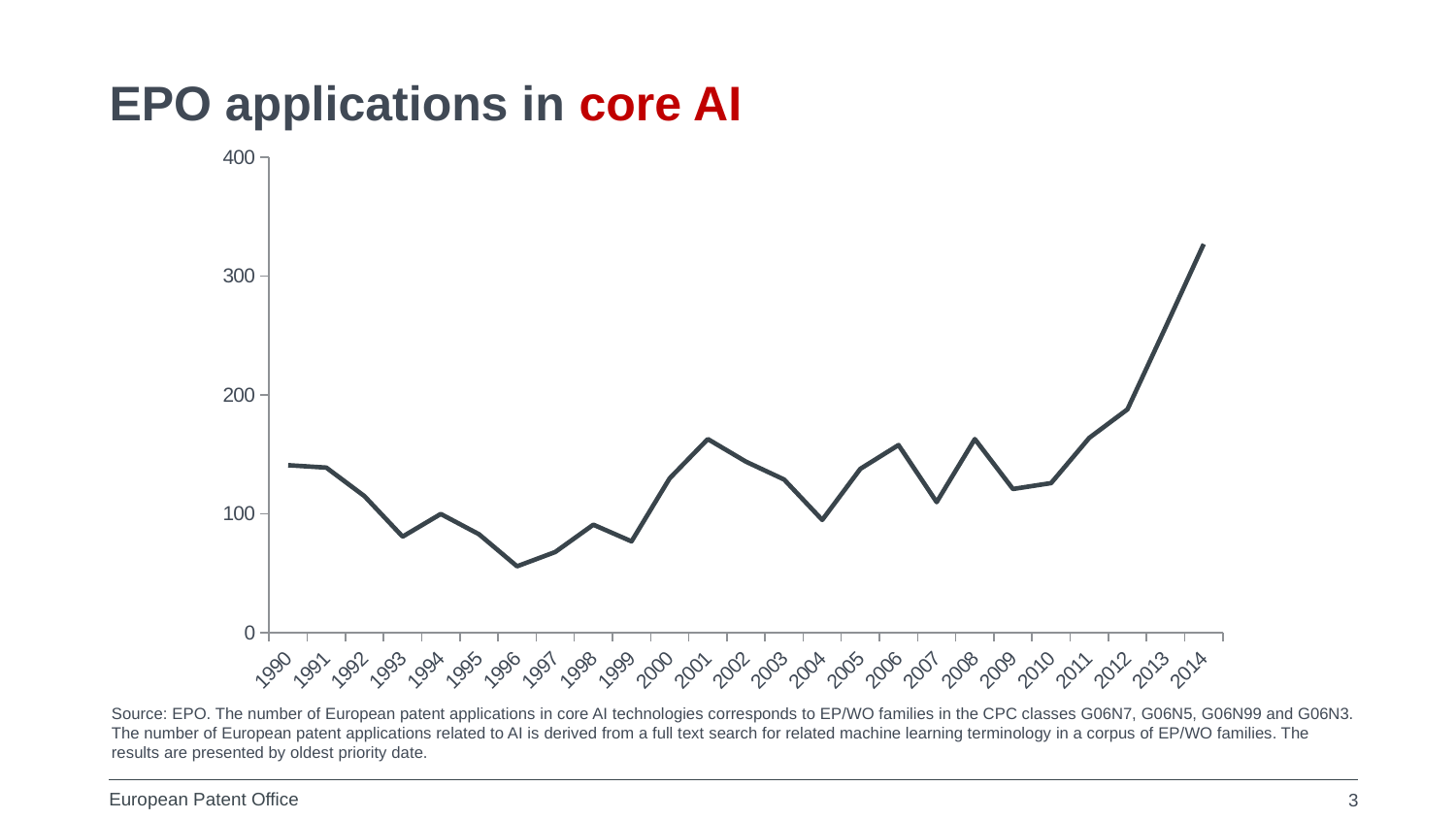
Is the value for 1993 greater or less than 100? less What kind of chart is shown on the slide? line chart Which year has the lowest number of EPO applications in core AI? 1996 Is the value for 2014 greater or less than 300? greater Which year has a larger value, 2014 or 1990? 2014 Do the values rise or fall from 2010 to 2014? rise Is the value for 2013 greater or less than 200? greater What is the title of the chart? EPO applications in core AI Which year has a larger value, 2000 or 1996? 2000 Which year has the highest number of EPO applications in core AI? 2014 How many years are plotted along the x axis? 25